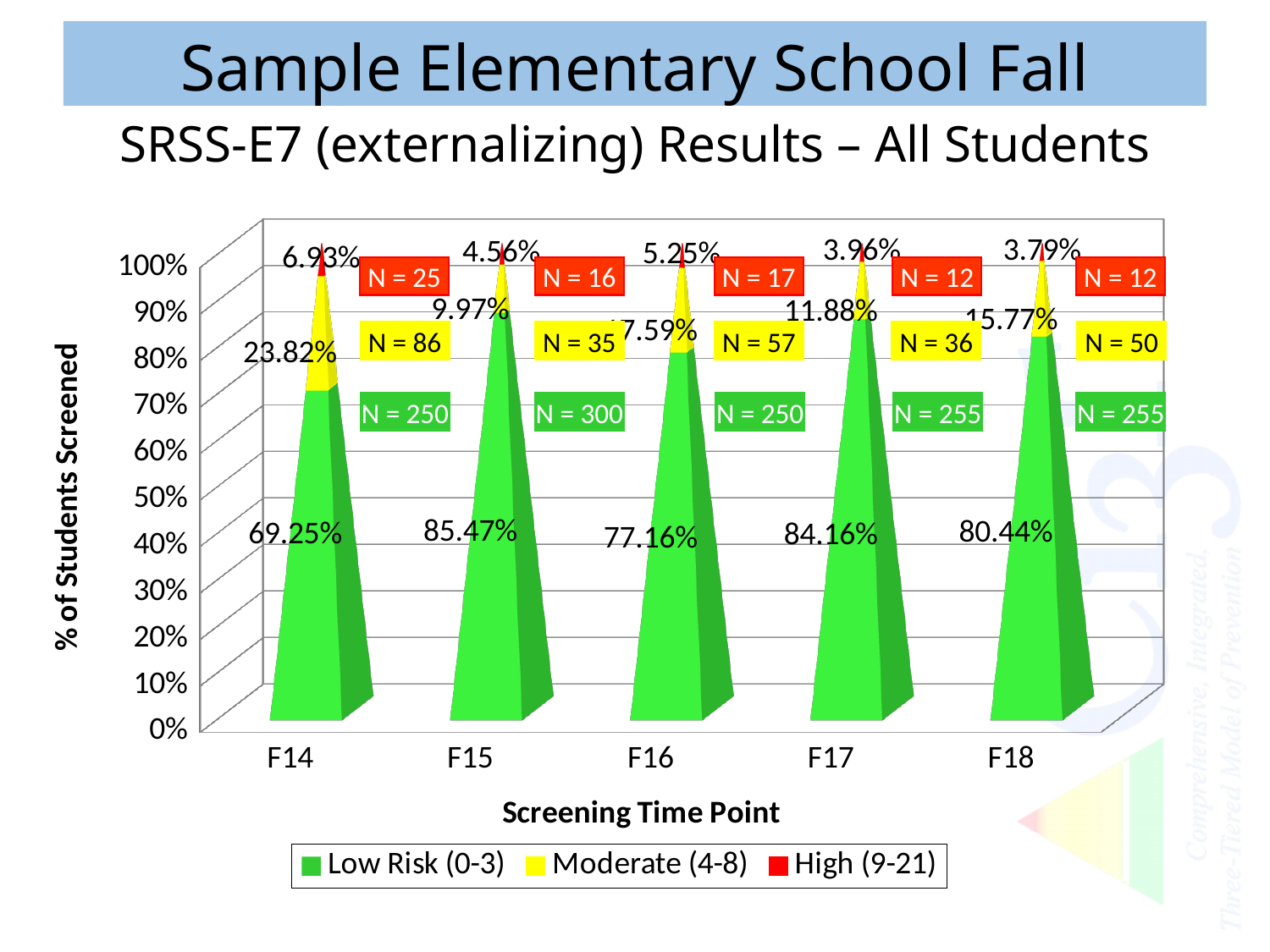
What kind of chart is shown on the slide? Stacked bar chart What is the difference between the Low Risk (0-3) percentages for F15 and F14? 16.22% Which screening time point has the highest Low Risk (0-3) percentage? F15 What is the Moderate (4-8) percentage for F17? 11.88% What is the Low Risk (0-3) percentage for F14? 69.25% What is the label of the y axis? % of Students Screened How many screening time points are shown on the x axis? 5 What is the Moderate (4-8) percentage for F15? 9.97% How many series does the legend list? 3 What is the High (9-21) percentage for F18? 3.79% Which is larger, the Low Risk (0-3) percentage for F17 or for F18? F17 Which screening time point has the lowest High (9-21) percentage? F18